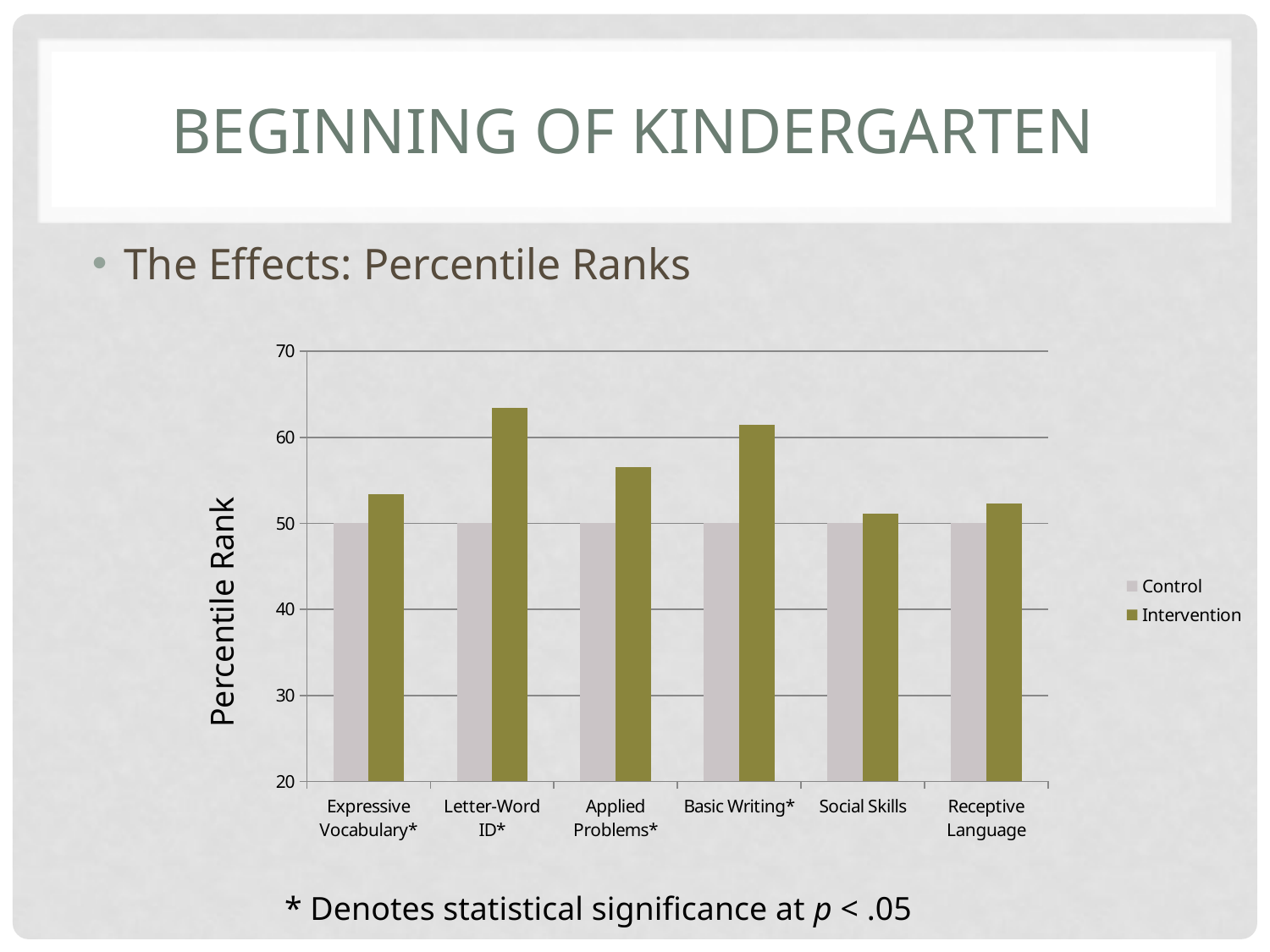
How many categories are shown on the x axis? 6 Which category has the highest Intervention value? Letter-Word ID* Is the Intervention value for Applied Problems* greater or less than 60? less What is the label on the y axis of the chart? Percentile Rank Is the Intervention value for Letter-Word ID* greater or less than 60? greater Which is larger: the Intervention value for Applied Problems* or the Intervention value for Basic Writing*? Basic Writing* How many series does the legend list? 2 For Letter-Word ID*, which is larger: the Control value or the Intervention value? Intervention What is the Control value for Letter-Word ID*? 50 What is the Control value for Social Skills? 50 Is the Intervention value for Basic Writing* greater or less than 60? greater What kind of chart is shown on the slide? bar chart